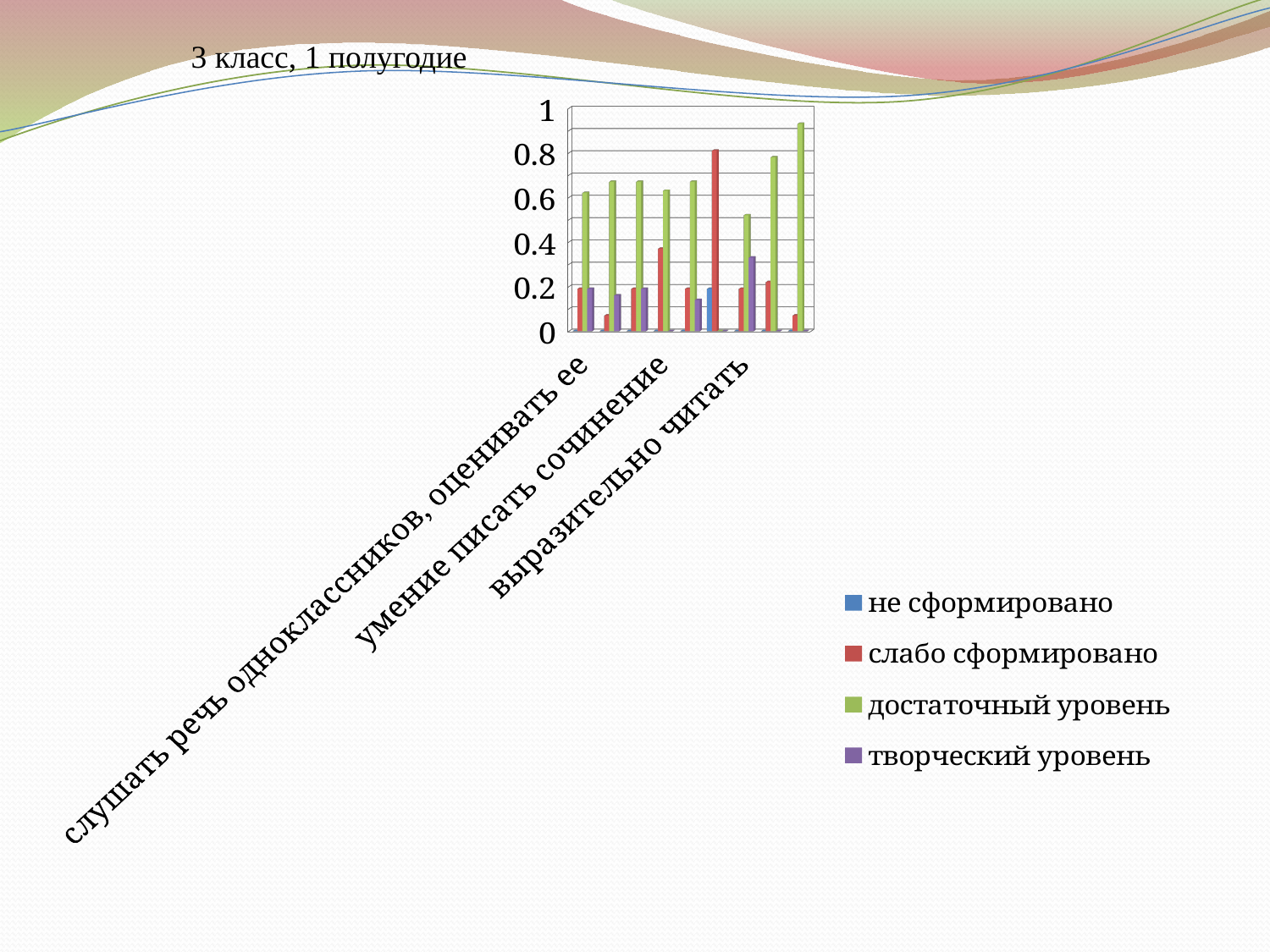
Which series has the tallest bar on the chart? достаточный уровень How many series does the legend list? 4 What is the highest value shown on the vertical axis? 1 Is the tallest red (слабо сформировано) bar greater or less than 0.6? greater What is the title text above the chart? 3 класс, 1 полугодие Is the tallest purple (творческий уровень) bar greater or less than 0.2? greater Which series is shown in green in the legend? достаточный уровень Is the tallest blue (не сформировано) bar greater or less than 0.4? less What kind of chart is shown on the slide? bar chart